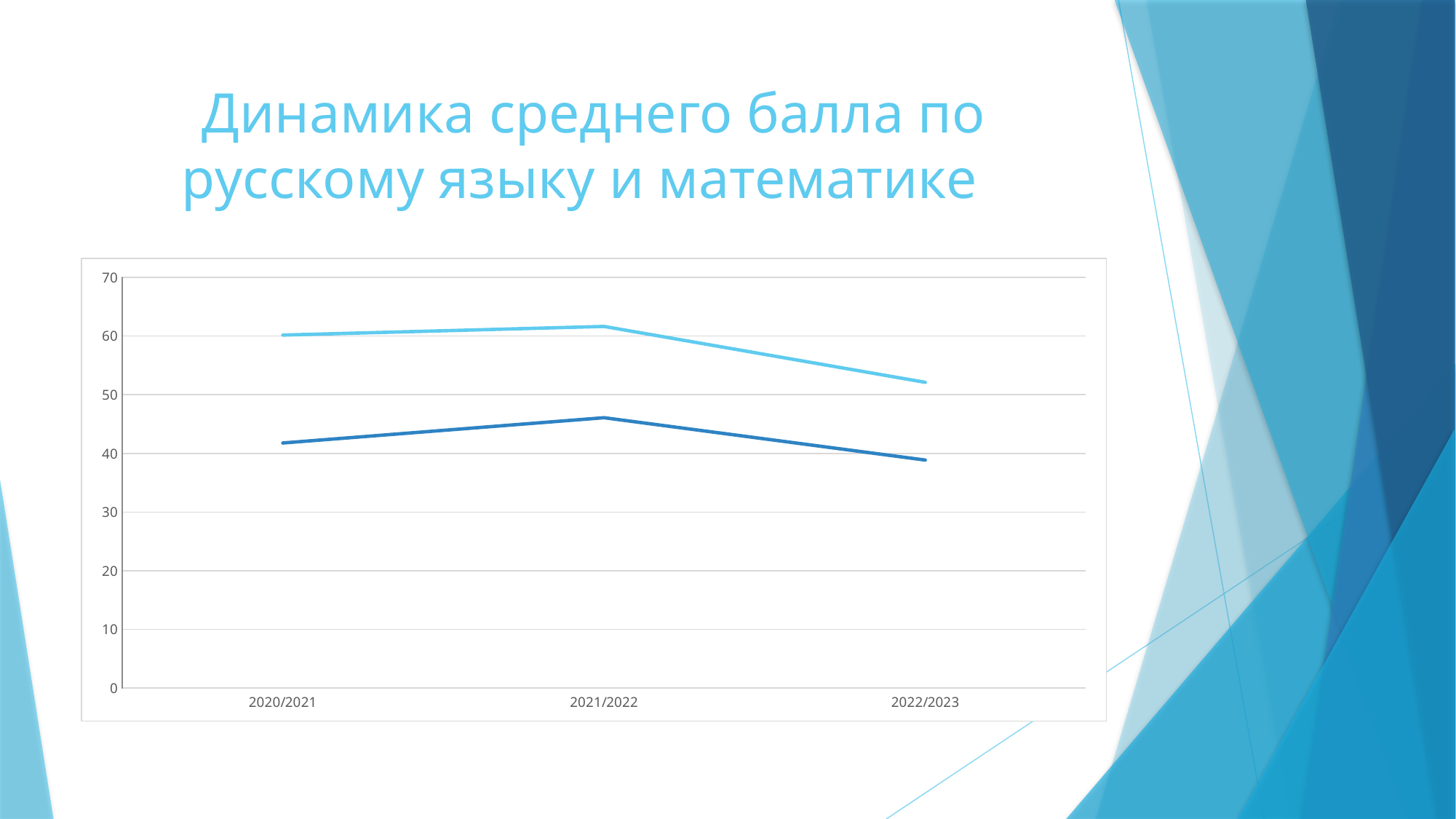
How many categories are shown on the x axis of the chart? 3 How many lines are plotted on the chart? 2 Is the value of the darker blue line for 2021/2022 greater or less than 50? less What kind of chart is shown on the slide? line chart What is the title of the slide containing the chart? Динамика среднего балла по русскому языку и математике Which line has the higher value in 2022/2023, the lighter blue line or the darker blue line? the lighter blue line Does the lighter blue line rise or fall between 2021/2022 and 2022/2023? fall In which year does the lighter blue line reach its lowest value? 2022/2023 Is the value of the lighter blue line for 2022/2023 greater or less than 50? greater Is the value of the darker blue line for 2022/2023 greater or less than 30? greater